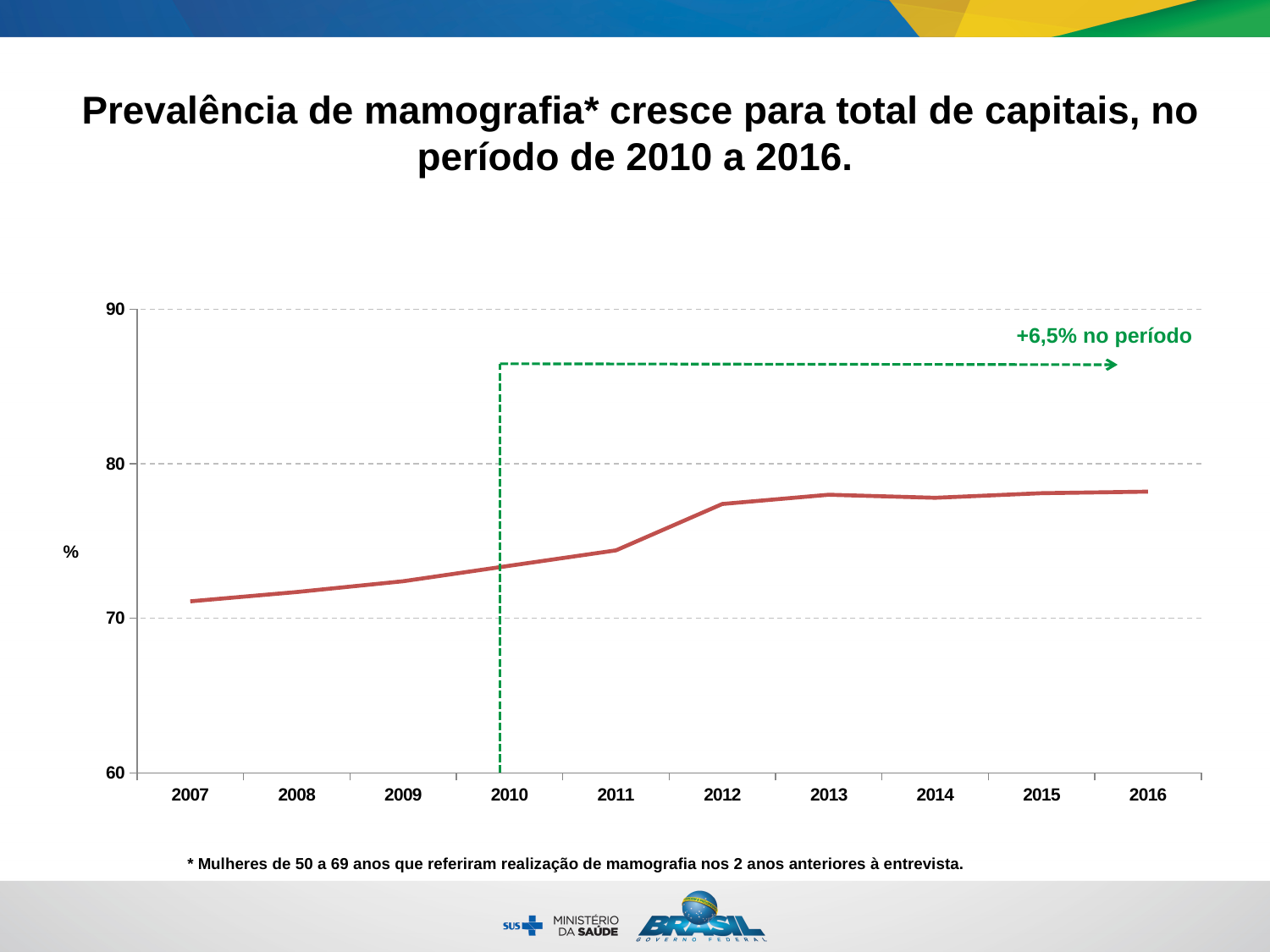
Is the value for 2016 greater or less than 70? greater Do the values on the chart rise or fall from 2007 to 2016? rise How many years are plotted along the x axis of the chart? 10 Which year has the lowest value on the chart? 2007 Which is larger, the value for 2007 or the value for 2013? 2013 Is the value for 2012 greater or less than 70? greater What kind of chart is shown on the slide? line chart Is the value for 2016 greater or less than 80? less What percentage change over the period is annotated on the chart? +6,5% no período What unit is shown on the y axis of the chart? %